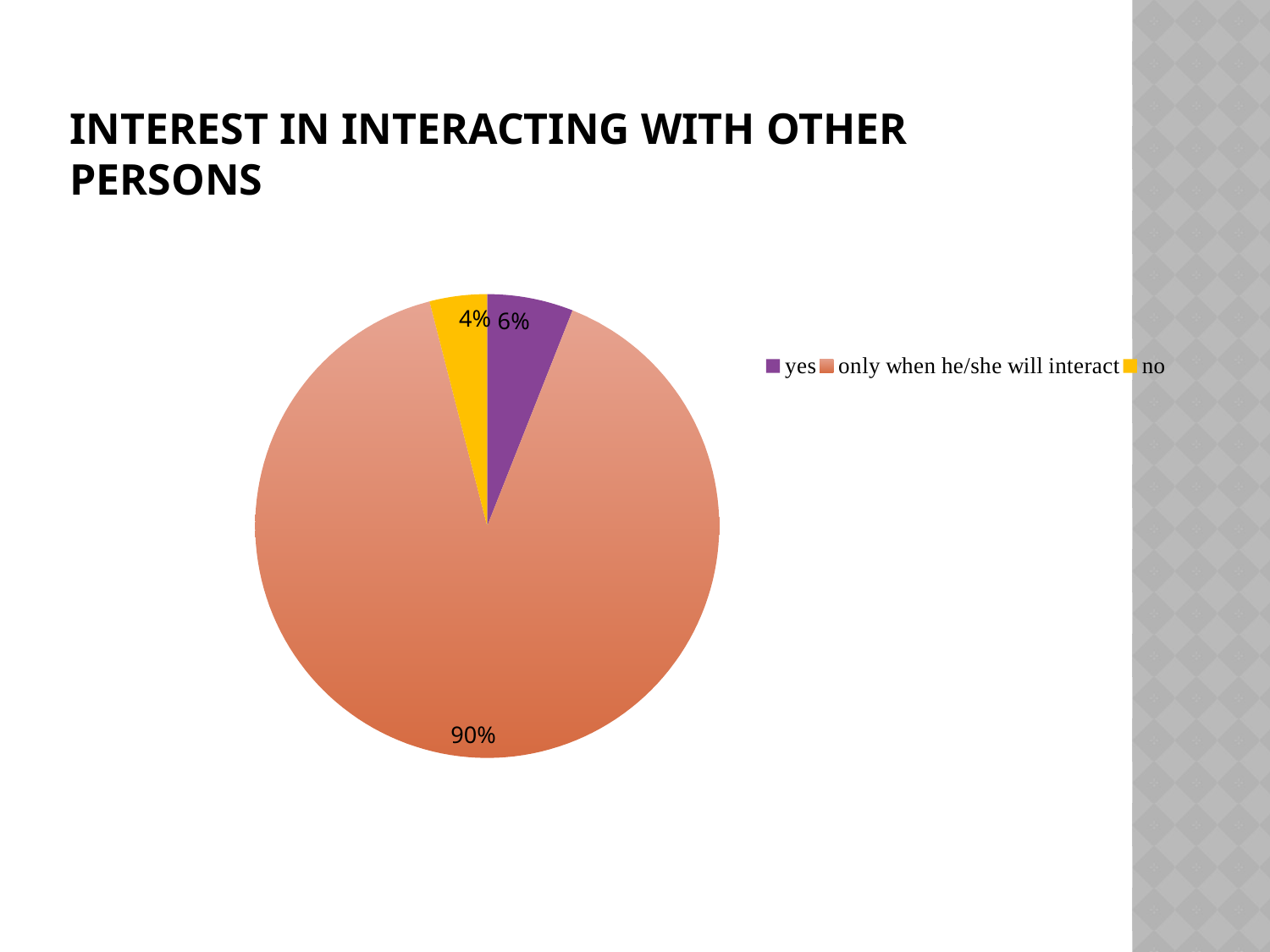
What is the difference between the shares for "yes" and "no"? 2% What share of the pie does "only when he/she will interact" take? 90% What colour is the slice for "no" in the pie chart? yellow Which is larger, the share for "yes" or the share for "no"? yes What is the title of the slide containing the pie chart? INTEREST IN INTERACTING WITH OTHER PERSONS Which category has the smallest slice of the pie? no How many categories does the pie chart show? 3 What is the difference between the shares for "only when he/she will interact" and "yes"? 84% What share of the pie does "yes" take? 6% What kind of chart is shown on the slide? pie chart Which category has the largest slice of the pie? only when he/she will interact What share of the pie does "no" take? 4%